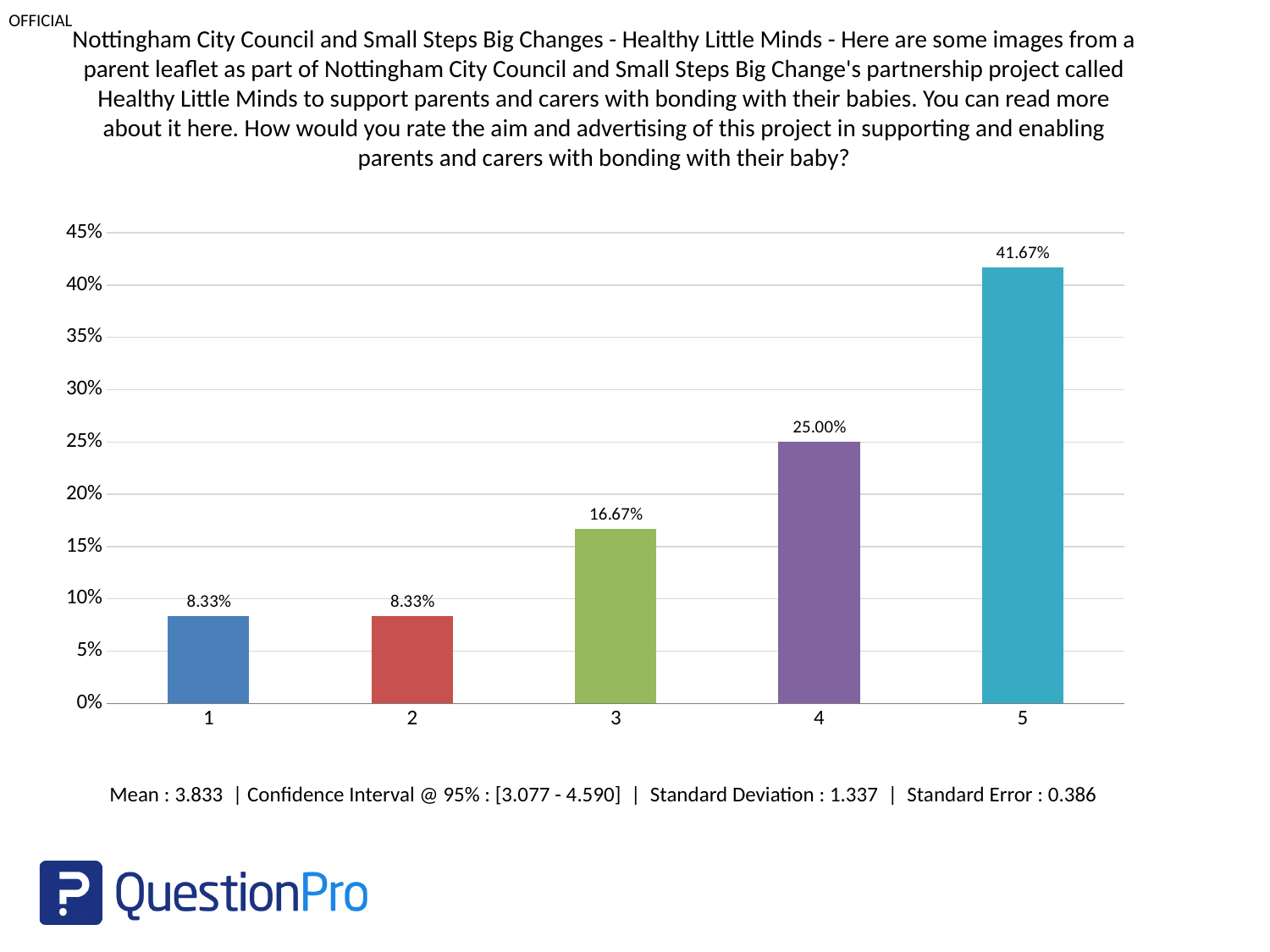
What mean value is reported below the chart? 3.833 Which is larger, the value for category 3 or the value for category 4? 4 What kind of chart is shown on the slide? bar chart What is the value for category 3? 16.67% How many categories are shown on the x axis? 5 Which category has the highest value? 5 Do the values rise or fall from category 2 to category 5? rise What is the value for category 4? 25.00% What is the difference between the values for category 5 and category 4? 16.67% What is the difference between the values for category 3 and category 1? 8.34% Is the value for category 5 greater or less than 40%? greater What is the value for category 5? 41.67%